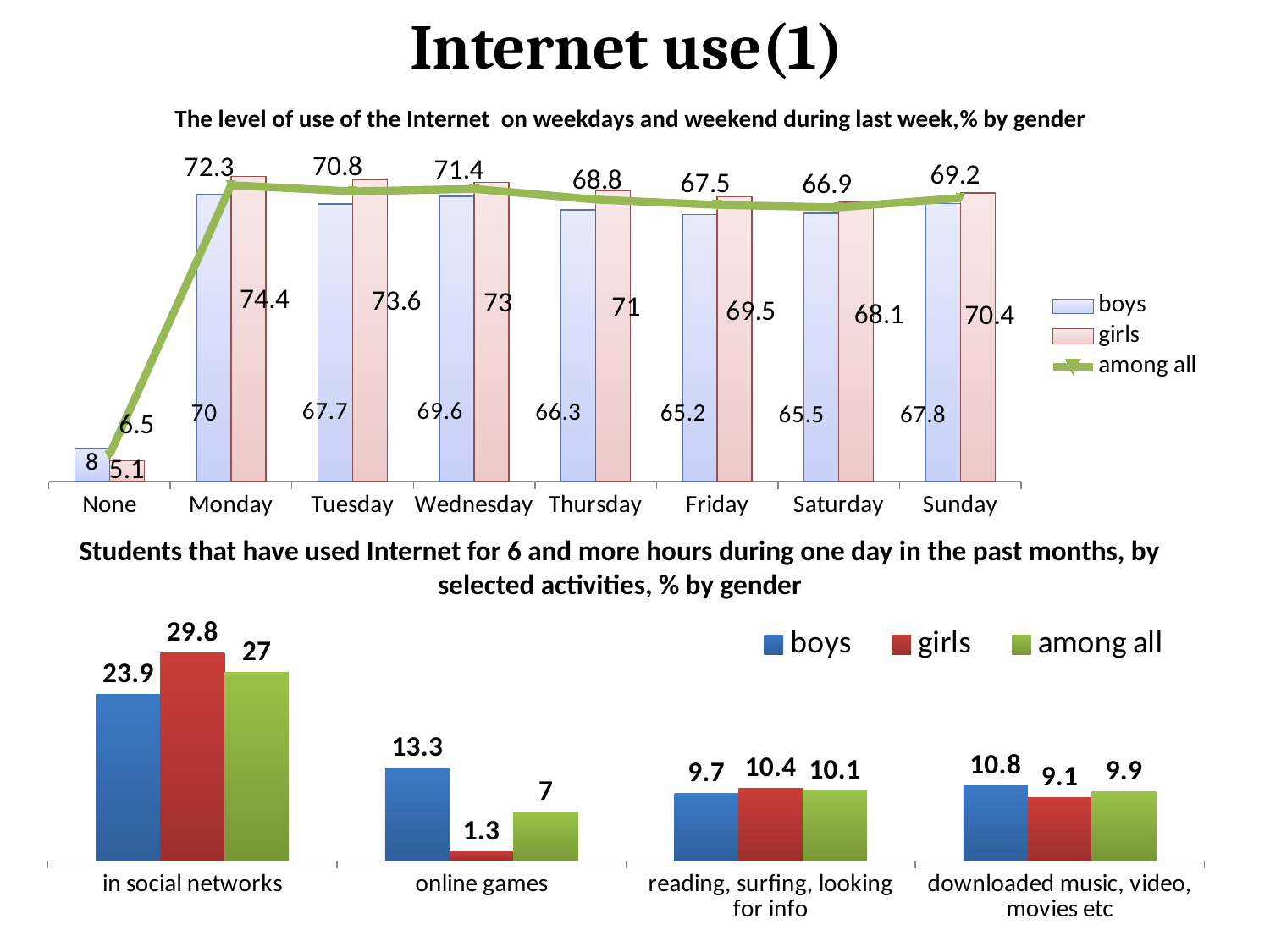
In the bottom chart (students using Internet 6 and more hours), which is larger for 'downloaded music, video, movies etc': boys or girls? boys In the top chart (level of Internet use during last week), how many series does the legend list? 3 In the top chart (level of Internet use during last week), what is the 'among all' value for Sunday? 69.2 In the top chart (level of Internet use during last week), what is the value for girls on Monday? 74.4 In the bottom chart (students using Internet 6 and more hours), which activity has the highest value for boys? in social networks In the bottom chart (students using Internet 6 and more hours), what is the difference between the girls and boys values for 'in social networks'? 5.9 In the top chart (level of Internet use during last week), how many categories are shown on the x axis? 8 What kind of chart is the bottom chart (students using Internet 6 and more hours)? bar chart In the top chart (level of Internet use during last week), what is the difference between the girls and boys values on Tuesday? 5.9 In the top chart (level of Internet use during last week), which series is drawn as a line rather than bars? among all In the top chart (level of Internet use during last week), which day has the lowest value for boys, excluding 'None'? Friday In the bottom chart (students using Internet 6 and more hours), what is the value for girls for online games? 1.3